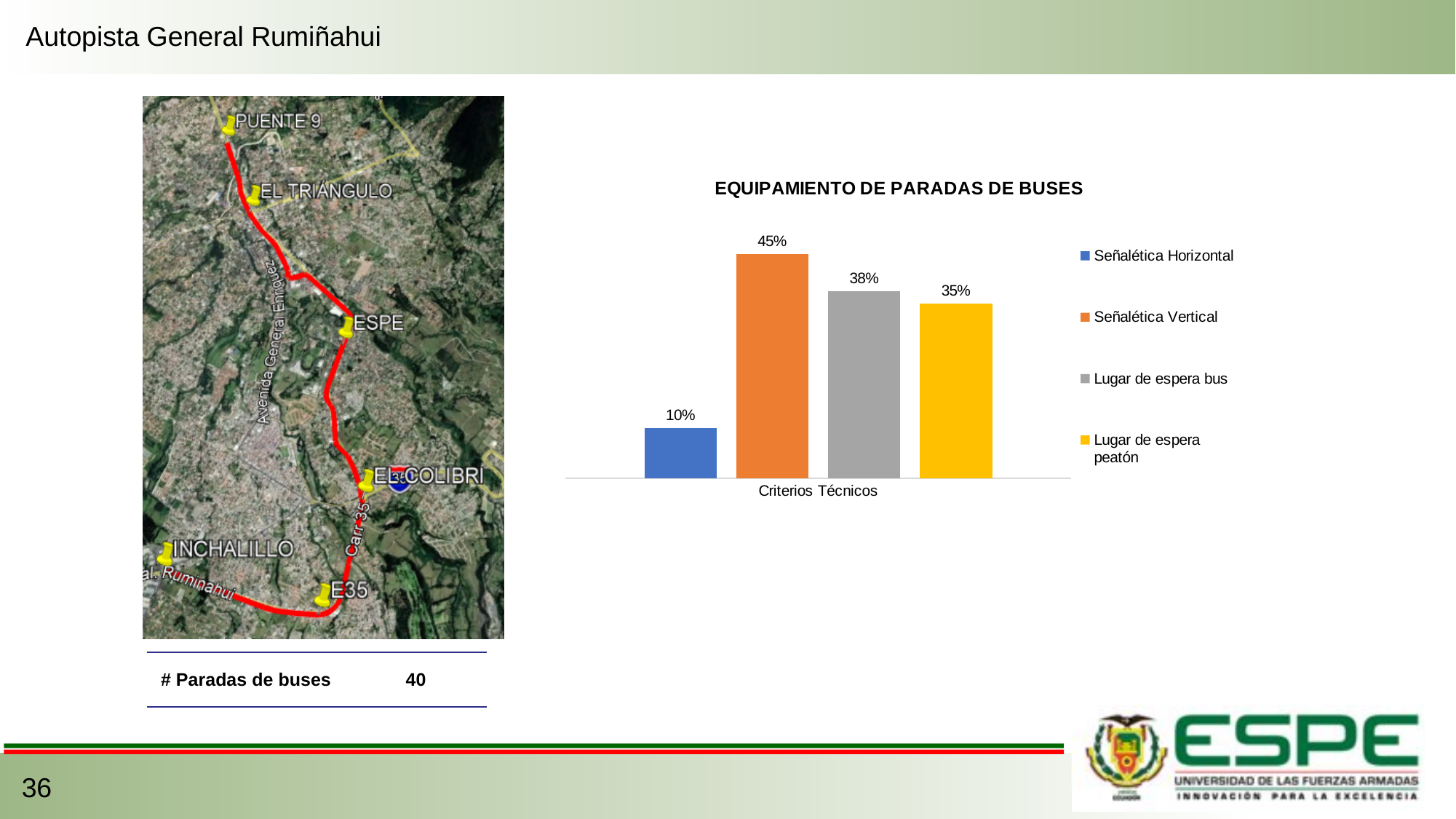
What is the value for Señalética Vertical in the chart? 45% What is the value for Lugar de espera bus in the chart? 38% What is the title of the chart? EQUIPAMIENTO DE PARADAS DE BUSES Which series has the highest value in the chart? Señalética Vertical What is the value for Lugar de espera peatón in the chart? 35% How many series does the legend list? 4 What kind of chart is shown on the slide? Bar chart What is the difference between the values for Señalética Vertical and Señalética Horizontal? 35% What is the difference between the values for Lugar de espera bus and Lugar de espera peatón? 3% Which series has the lowest value in the chart? Señalética Horizontal Which is larger, the value for Lugar de espera bus or the value for Señalética Horizontal? Lugar de espera bus What is the value for Señalética Horizontal in the chart? 10%